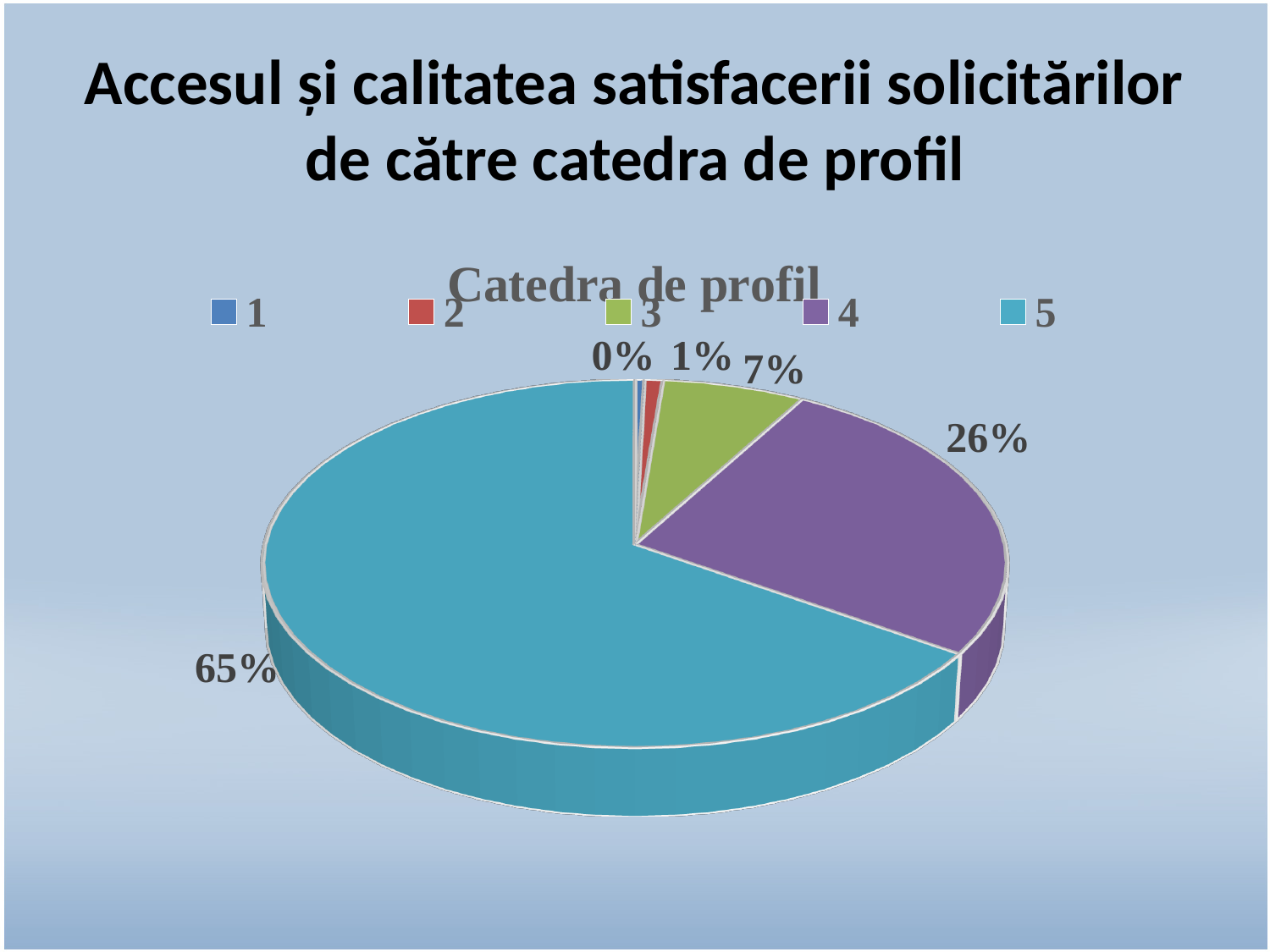
What share of the pie does category 2 have? 1% What share of the pie does category 5 have? 65% What is the difference between the shares of category 5 and category 4? 39% What share of the pie does category 1 have? 0% How many categories does the legend list? 5 Which is larger, the share of category 3 or category 4? 4 What kind of chart is shown on the slide? pie chart Which category has the largest slice? 5 Which category has the smallest slice? 1 What is the chart's title? Catedra de profil